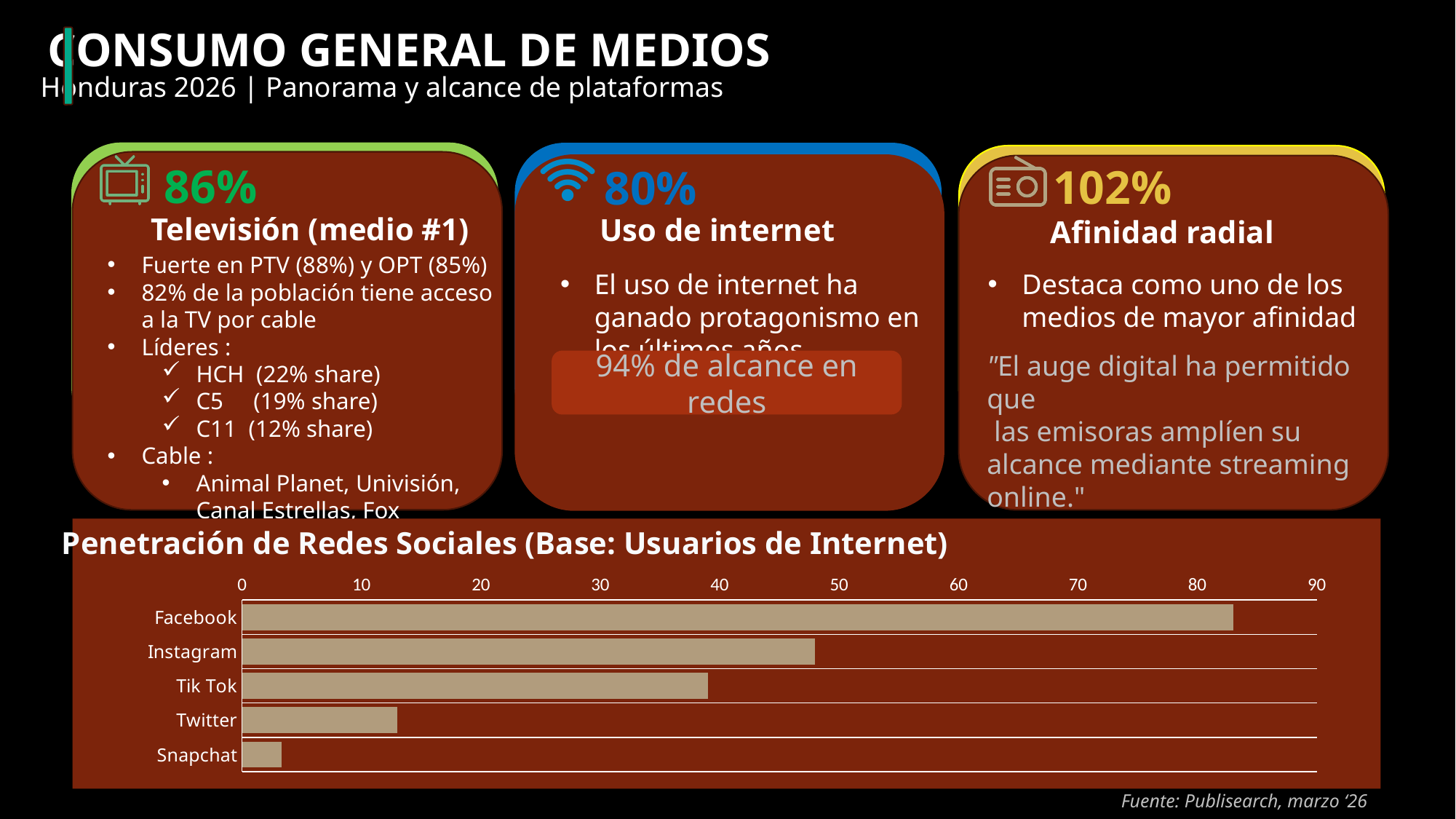
In the 'Penetración de Redes Sociales' chart, which has the larger value, Instagram or Tik Tok? Instagram In the 'Penetración de Redes Sociales' chart, is the value for Snapchat greater or less than 10? less In the 'Penetración de Redes Sociales' chart, is the value for Facebook greater or less than 80? greater How many social networks are plotted in the 'Penetración de Redes Sociales' chart? 5 In the 'Penetración de Redes Sociales' chart, is the value for Tik Tok greater or less than 30? greater What kind of chart is shown under 'Penetración de Redes Sociales'? bar chart In the 'Penetración de Redes Sociales' chart, which has the larger value, Twitter or Snapchat? Twitter What is the title of the bar chart at the bottom of the slide? Penetración de Redes Sociales (Base: Usuarios de Internet) Which social network has the lowest penetration in the 'Penetración de Redes Sociales' chart? Snapchat Which social network has the highest penetration in the 'Penetración de Redes Sociales' chart? Facebook